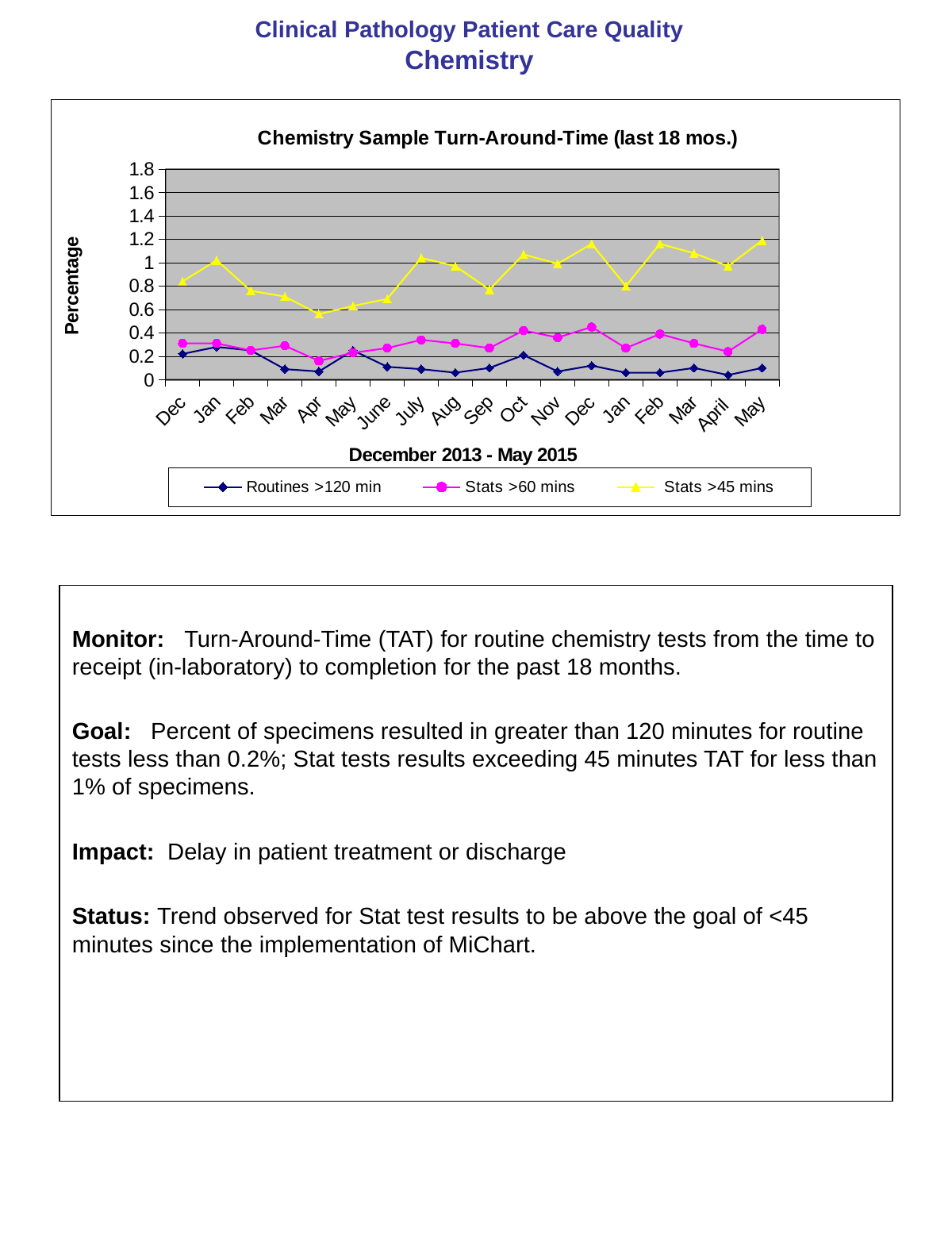
What is the label on the y axis? Percentage Is the value for Stats >45 mins in Dec 2014 greater or less than 1? greater How many series does the legend list? 3 What kind of chart is shown on the slide? line chart Which month has the lowest value for Stats >45 mins? Apr (2014) How many months are plotted along the x axis? 18 What is the title of the chart? Chemistry Sample Turn-Around-Time (last 18 mos.) Is the value for Routines >120 min in Apr 2014 greater or less than 0.2? less Which series has the higher value in July: Stats >45 mins or Stats >60 mins? Stats >45 mins Is the value for Stats >60 mins in Dec 2014 greater or less than 0.4? greater Which is larger for Stats >45 mins: the value in Jan 2014 or the value in Apr 2014? Jan 2014